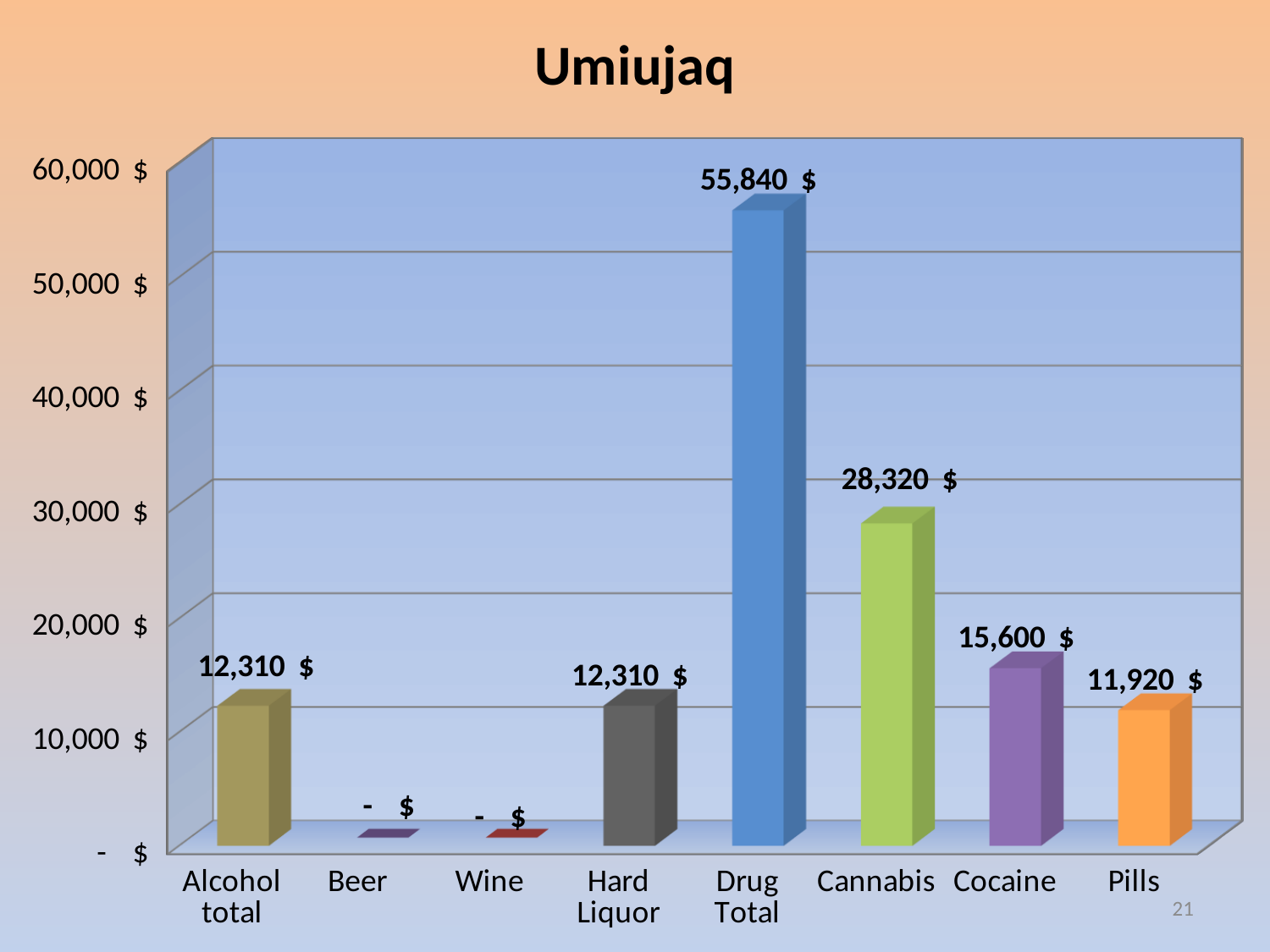
What is the difference between Cocaine and Pills? 3,680 $ What is the value for Cannabis? 28,320 $ What is the difference between Drug Total and Cannabis? 27,520 $ What is the value for Cocaine? 15,600 $ Which category has the highest value? Drug Total What is the value for Pills? 11,920 $ How many categories are shown on the x axis? 8 What is the title of the chart? Umiujaq What is the value for Drug Total? 55,840 $ What kind of chart is shown? bar chart Which is larger, Cannabis or Cocaine? Cannabis What is the value for Hard Liquor? 12,310 $